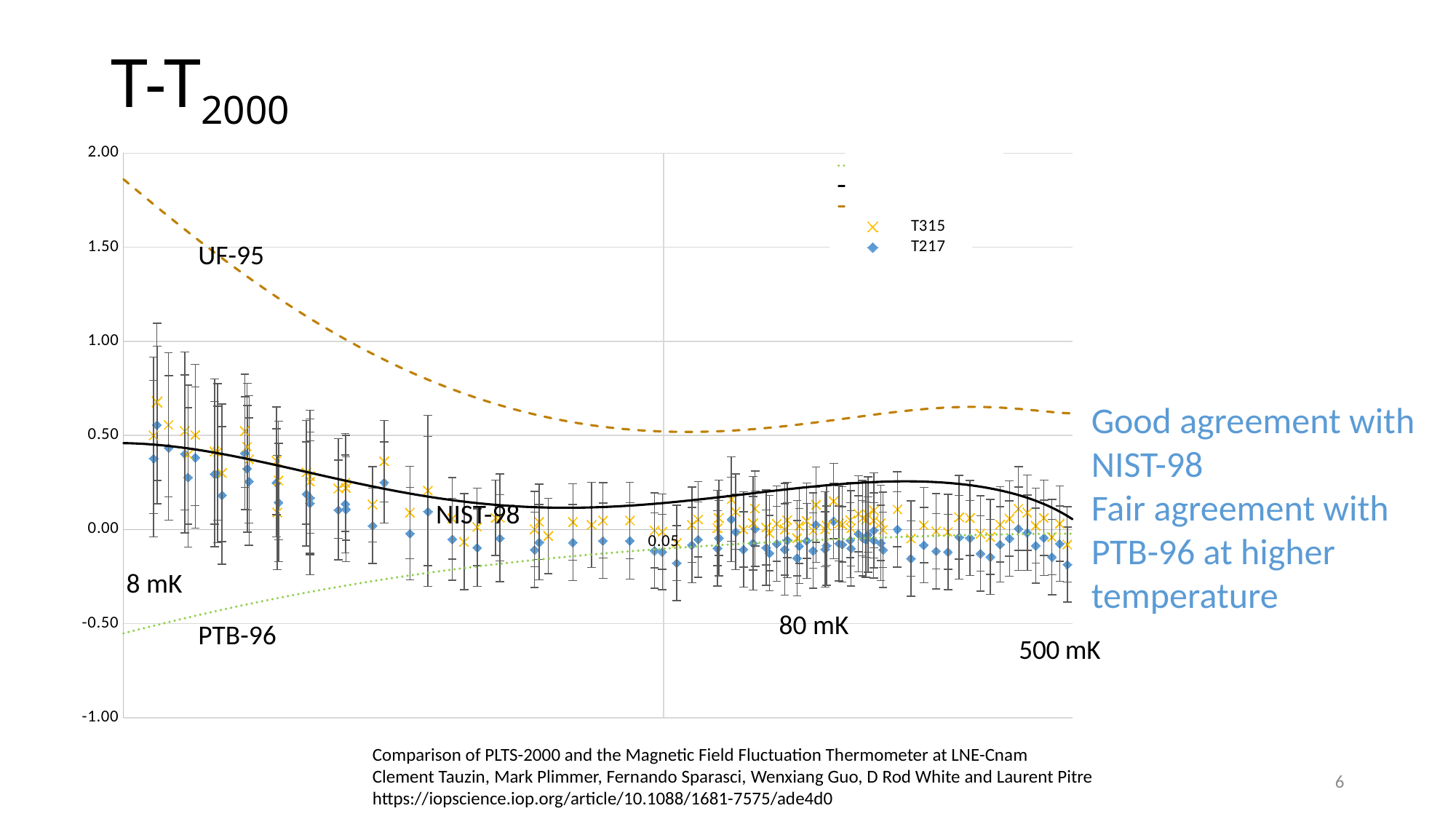
Which of the three labelled curves (UF-95, NIST-98, PTB-96) is lowest at the left edge of the chart? PTB-96 At the right edge of the chart, which curve is higher, UF-95 or NIST-98? UF-95 Does the UF-95 curve rise or fall from the left edge of the chart toward the middle? fall Is the value of the PTB-96 curve at the left edge of the chart greater or less than 0.00? less Is the value of the UF-95 curve at the right edge of the chart greater or less than 0.50? greater What kind of chart is shown on the slide? scatter chart Which marker symbol does the legend use for the T217 series? blue diamond Which of the three labelled curves (UF-95, NIST-98, PTB-96) is highest at the left edge of the chart? UF-95 Is the value of the UF-95 curve at the left edge of the chart greater or less than 1.50? greater Does the PTB-96 curve rise or fall from the left edge of the chart toward the middle? rise What is the highest value shown on the vertical axis? 2.00